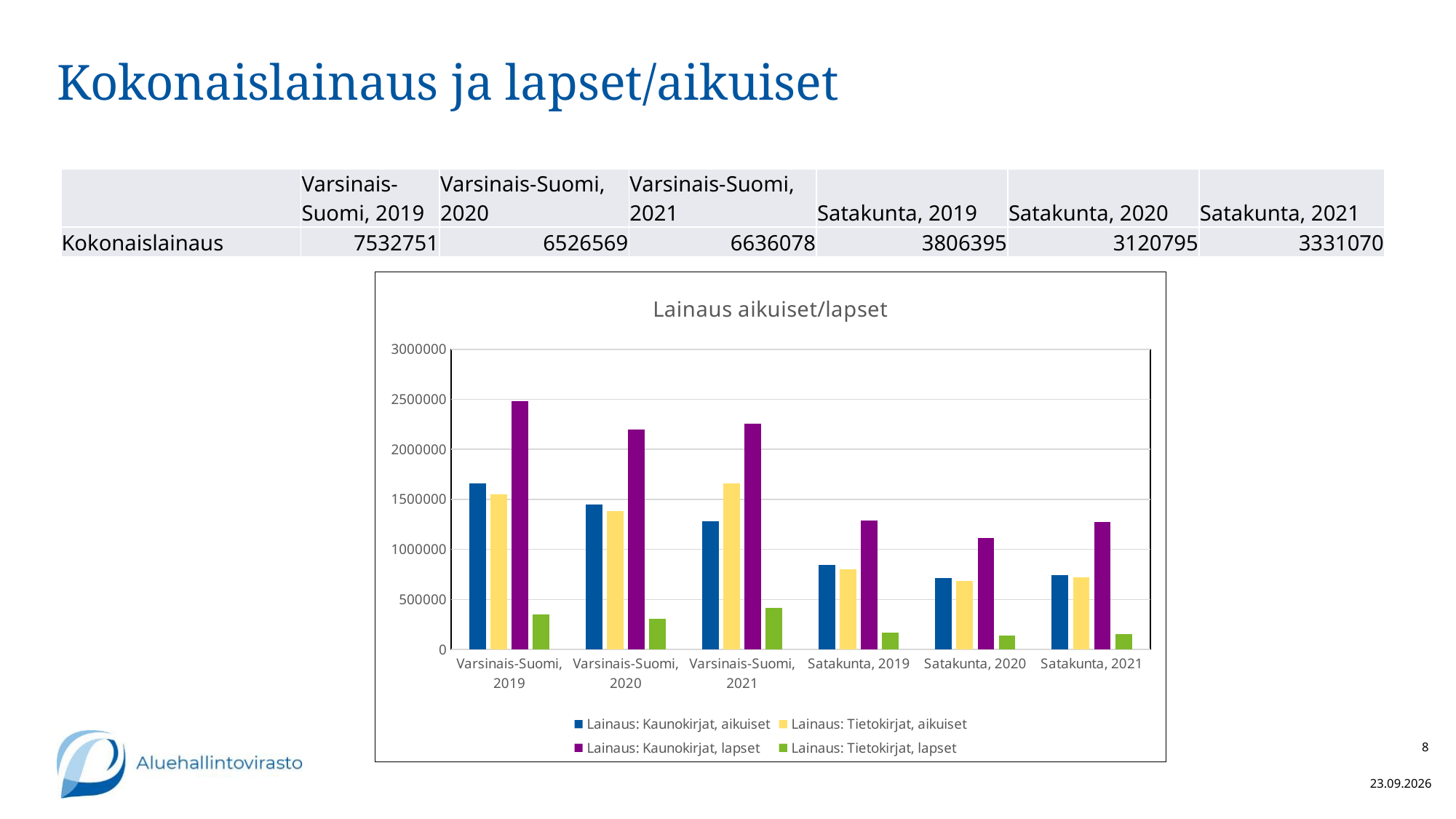
Which category has the lowest value for Lainaus: Kaunokirjat, lapset? Satakunta, 2020 What is the title of the chart? Lainaus aikuiset/lapset How many categories are shown along the x axis of the chart? 6 What colour are the bars for Lainaus: Kaunokirjat, lapset? Purple How many series does the chart legend list? 4 Is the value for Lainaus: Tietokirjat, lapset in Satakunta, 2019 greater or less than 500000? less In Varsinais-Suomi, 2021, which is larger: Lainaus: Kaunokirjat, aikuiset or Lainaus: Tietokirjat, aikuiset? Lainaus: Tietokirjat, aikuiset Does the value for Lainaus: Kaunokirjat, aikuiset in Varsinais-Suomi rise or fall from 2019 to 2021? Fall Is the value for Lainaus: Kaunokirjat, aikuiset in Varsinais-Suomi, 2019 greater or less than 1500000? greater Is the value for Lainaus: Kaunokirjat, lapset in Varsinais-Suomi, 2019 greater or less than 2000000? greater What kind of chart is shown on the slide? Bar chart Which category has the highest value for Lainaus: Kaunokirjat, lapset? Varsinais-Suomi, 2019